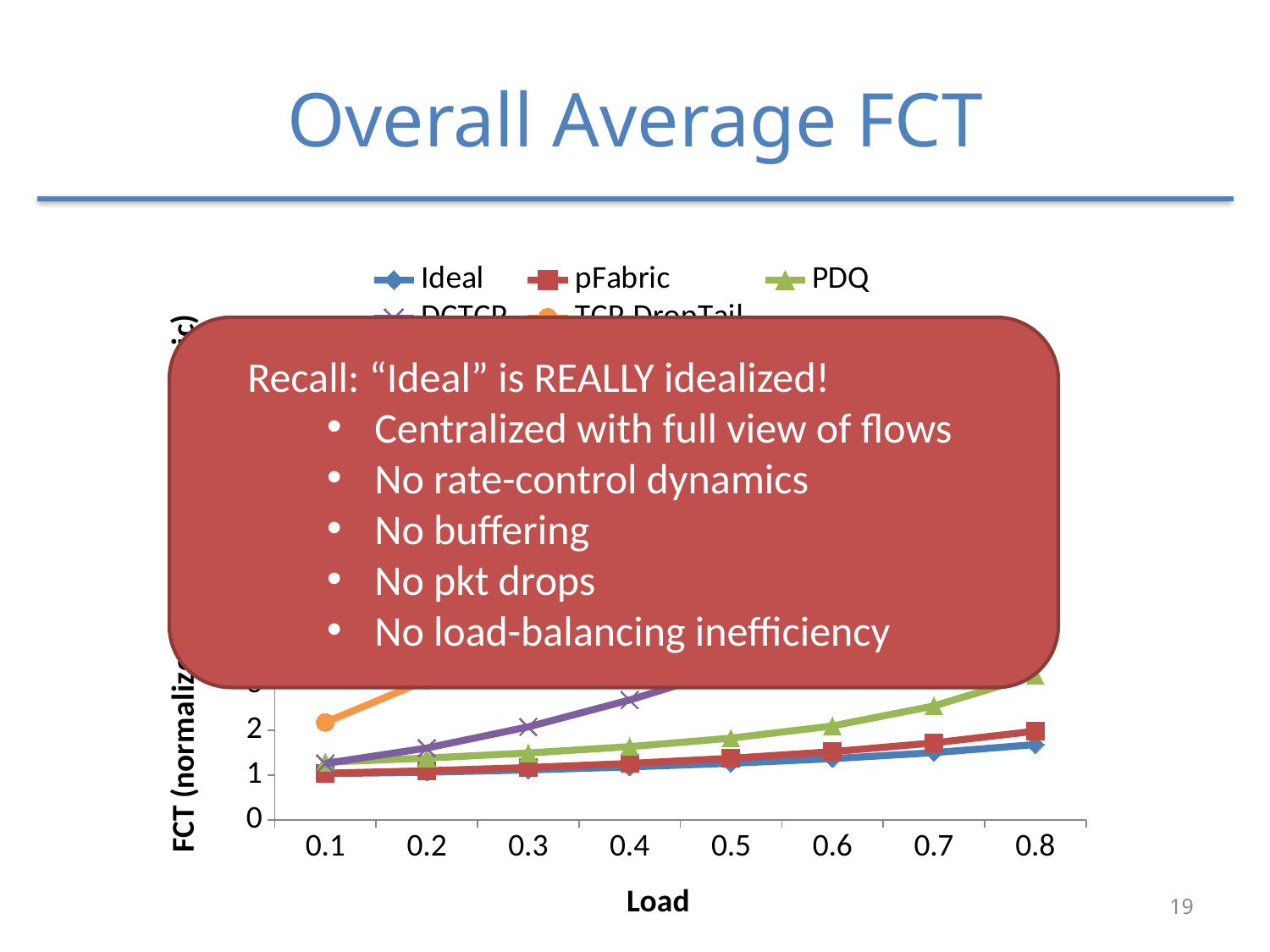
At load 0.4, which is larger, DCTCP or pFabric? DCTCP What is the title of the x axis? Load Which series has the highest value at load 0.1? TCP DropTail How many load values are plotted along the x axis? 8 Is the value for Ideal at load 0.8 greater or less than 2? less How many series does the legend list? 5 Is the value for PDQ at load 0.8 greater or less than 2? greater Does the Ideal series rise or fall as load increases? rise Is the value for DCTCP at load 0.4 greater or less than 2? greater What is the title of the chart? Overall Average FCT What kind of chart is shown on the slide? line chart At load 0.8, which is larger, PDQ or Ideal? PDQ